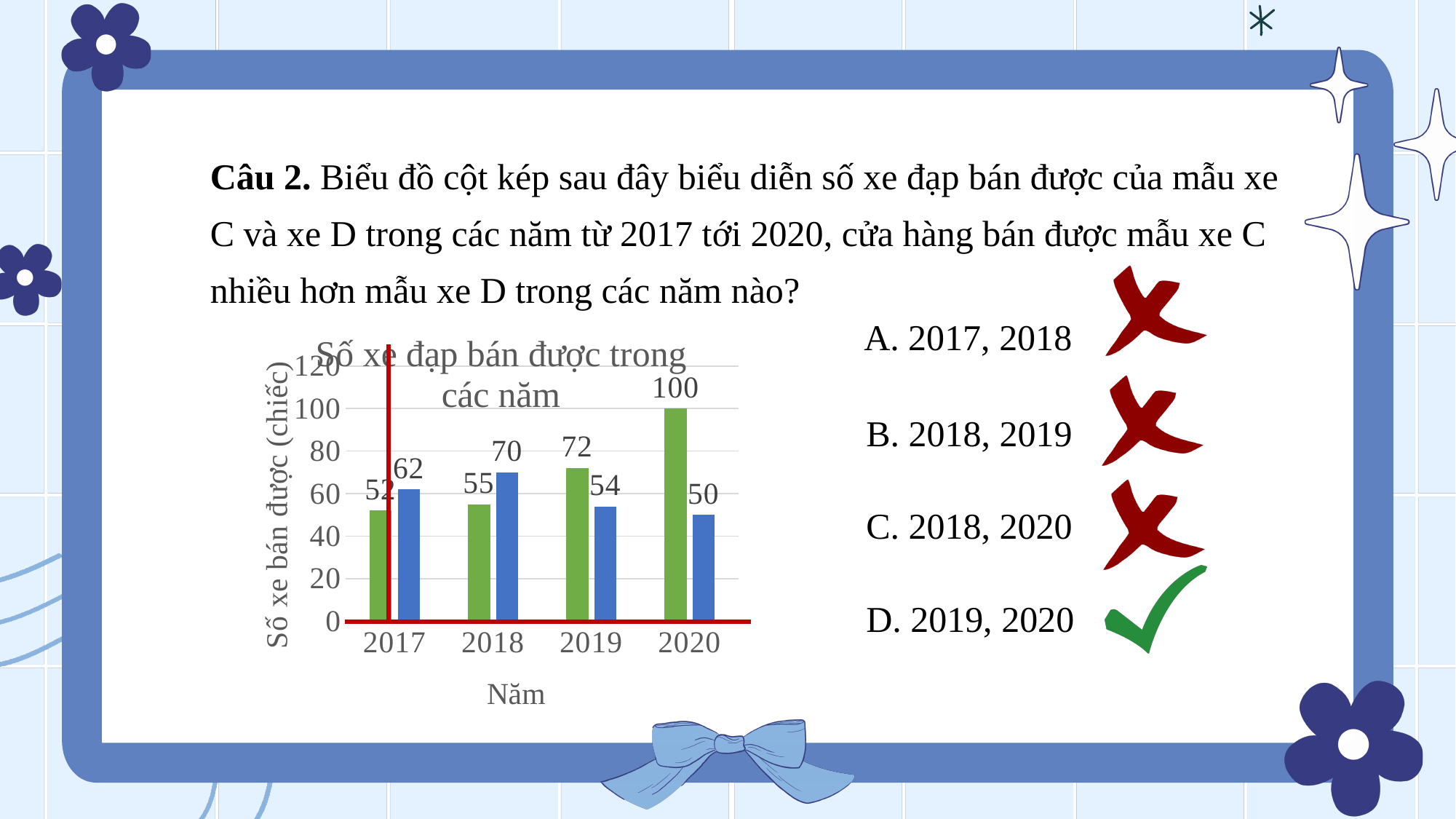
What kind of chart is shown on the slide? bar chart What is the difference between the green bar and the blue bar in 2020? 50 What is the value of the green bar for 2020? 100 In which year is the blue bar lowest? 2020 In which year is the green bar highest? 2020 In 2019, which bar is larger, the green bar or the blue bar? the green bar What is the title of the chart? Số xe đạp bán được trong các năm Do the green bars rise or fall from 2017 to 2020? rise How many years are shown on the x axis? 4 What is the value of the green bar for 2017? 52 What is the value of the blue bar for 2018? 70 What is the difference between the blue bar and the green bar in 2018? 15